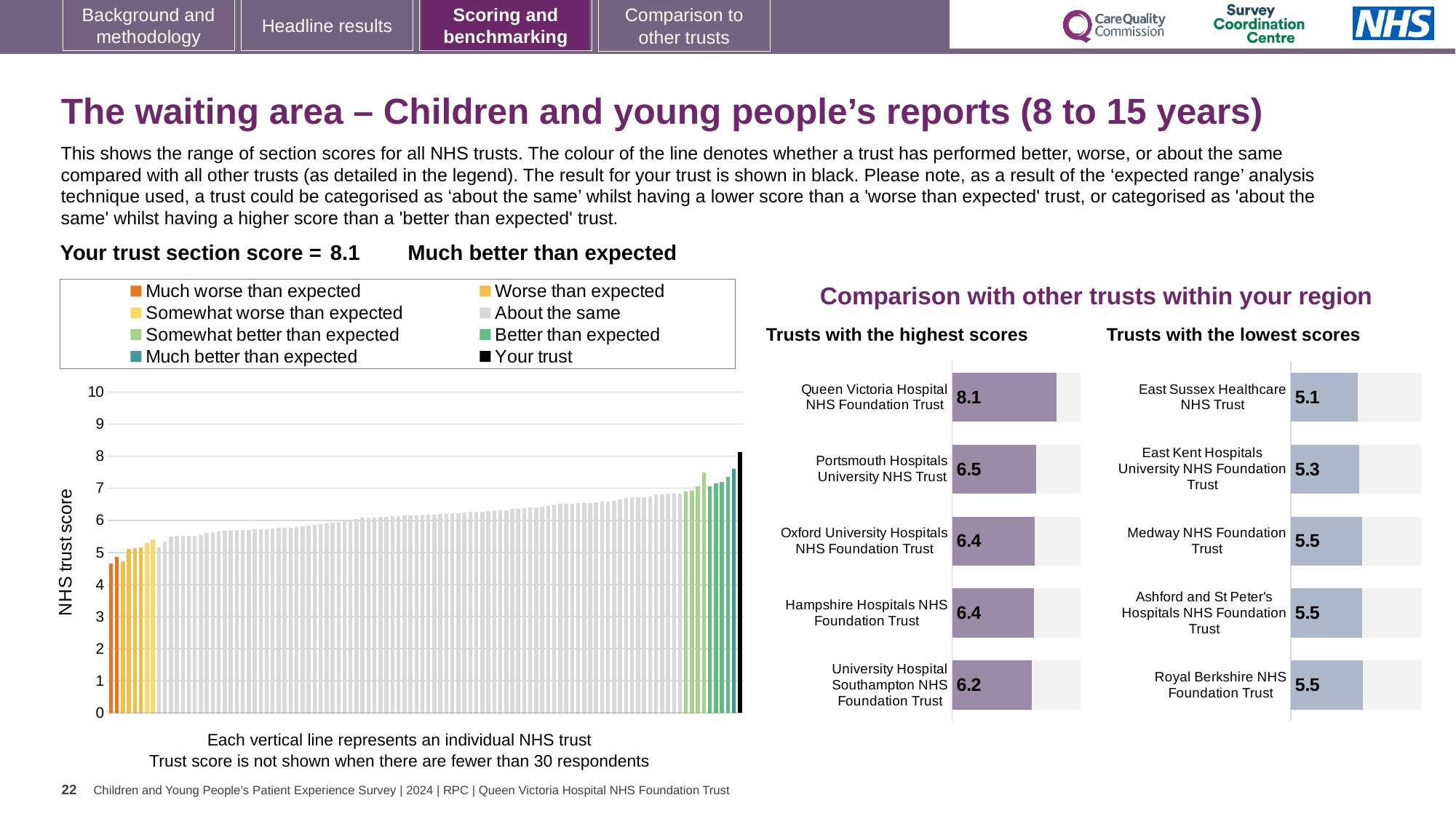
In the large 'NHS trust score' chart on the left, do the bar values rise or fall from left to right? Rise How many trusts are shown in the 'Trusts with the highest scores' chart? 5 In the 'Trusts with the lowest scores' chart, which trust has the lowest score? East Sussex Healthcare NHS Trust In the 'Trusts with the highest scores' chart, what is the score for Queen Victoria Hospital NHS Foundation Trust? 8.1 In the 'Trusts with the highest scores' chart, which trust has the lowest score? University Hospital Southampton NHS Foundation Trust In the 'Trusts with the highest scores' chart, what is the difference between the scores of Queen Victoria Hospital NHS Foundation Trust and Portsmouth Hospitals University NHS Trust? 1.6 In the 'Trusts with the lowest scores' chart, what is the score for East Sussex Healthcare NHS Trust? 5.1 In the 'Trusts with the lowest scores' chart, which is larger: the score for East Kent Hospitals University NHS Foundation Trust or Medway NHS Foundation Trust? Medway NHS Foundation Trust In the 'Trusts with the lowest scores' chart, what is the score for Medway NHS Foundation Trust? 5.5 In the 'Trusts with the lowest scores' chart, what is the difference between the scores of East Kent Hospitals University NHS Foundation Trust and East Sussex Healthcare NHS Trust? 0.2 What kind of chart is the large 'NHS trust score' chart on the left of the slide? Bar chart In the 'Trusts with the highest scores' chart, what is the score for Portsmouth Hospitals University NHS Trust? 6.5